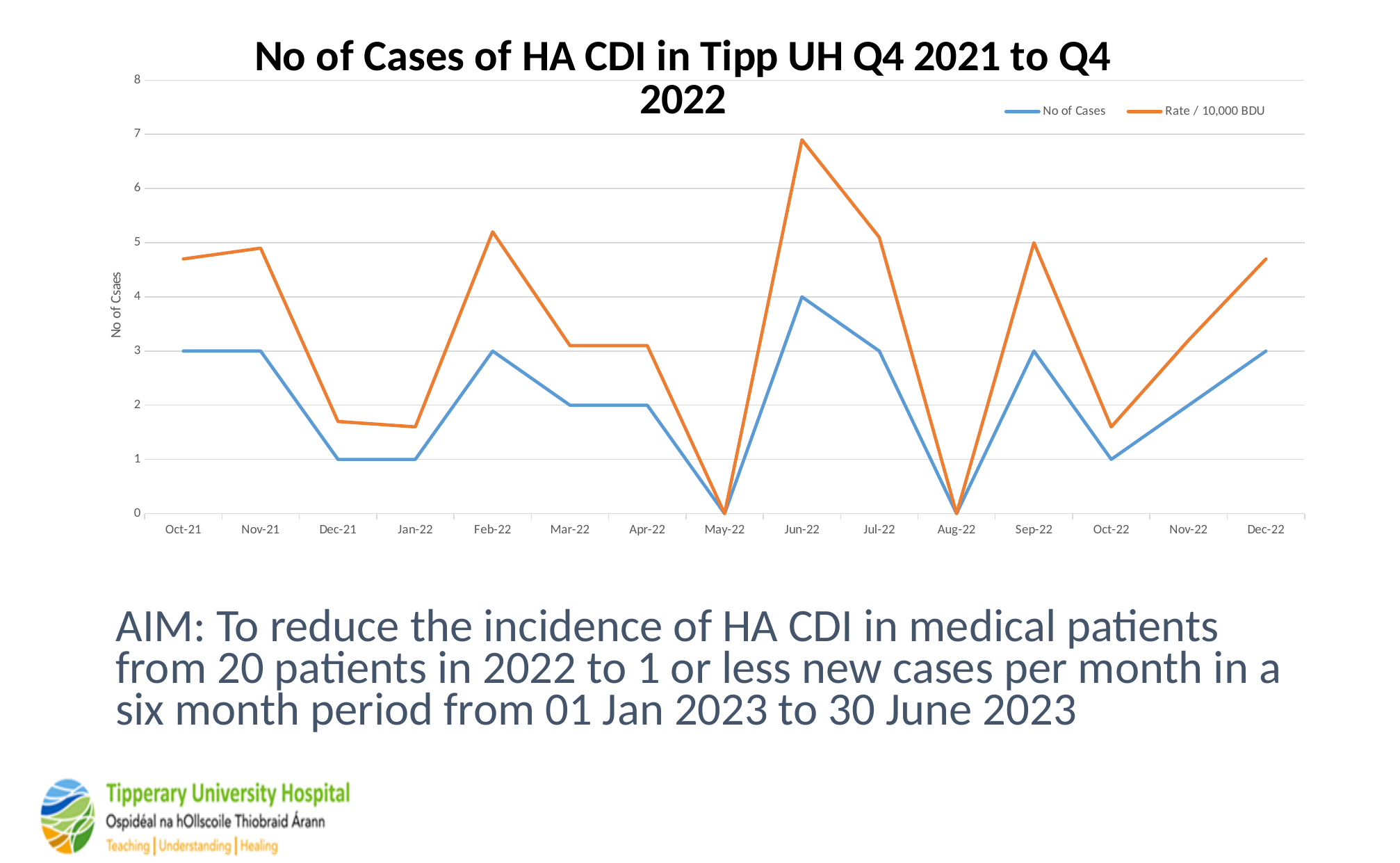
What is the No of Cases value for Jun-22? 4 Does the No of Cases series rise or fall from Oct-22 to Dec-22? rise What kind of chart is shown on the slide? line chart How many months are plotted along the x axis? 15 Which month has more cases, Feb-22 or Mar-22? Feb-22 What is the difference between the No of Cases in Jun-22 and in Oct-22? 3 How many series does the legend list? 2 In which month is the Rate / 10,000 BDU series highest? Jun-22 What is the No of Cases value for Mar-22? 2 In which month is the No of Cases series highest? Jun-22 What is the No of Cases value for Dec-21? 1 Is the Rate / 10,000 BDU value for Jun-22 greater or less than 6? greater